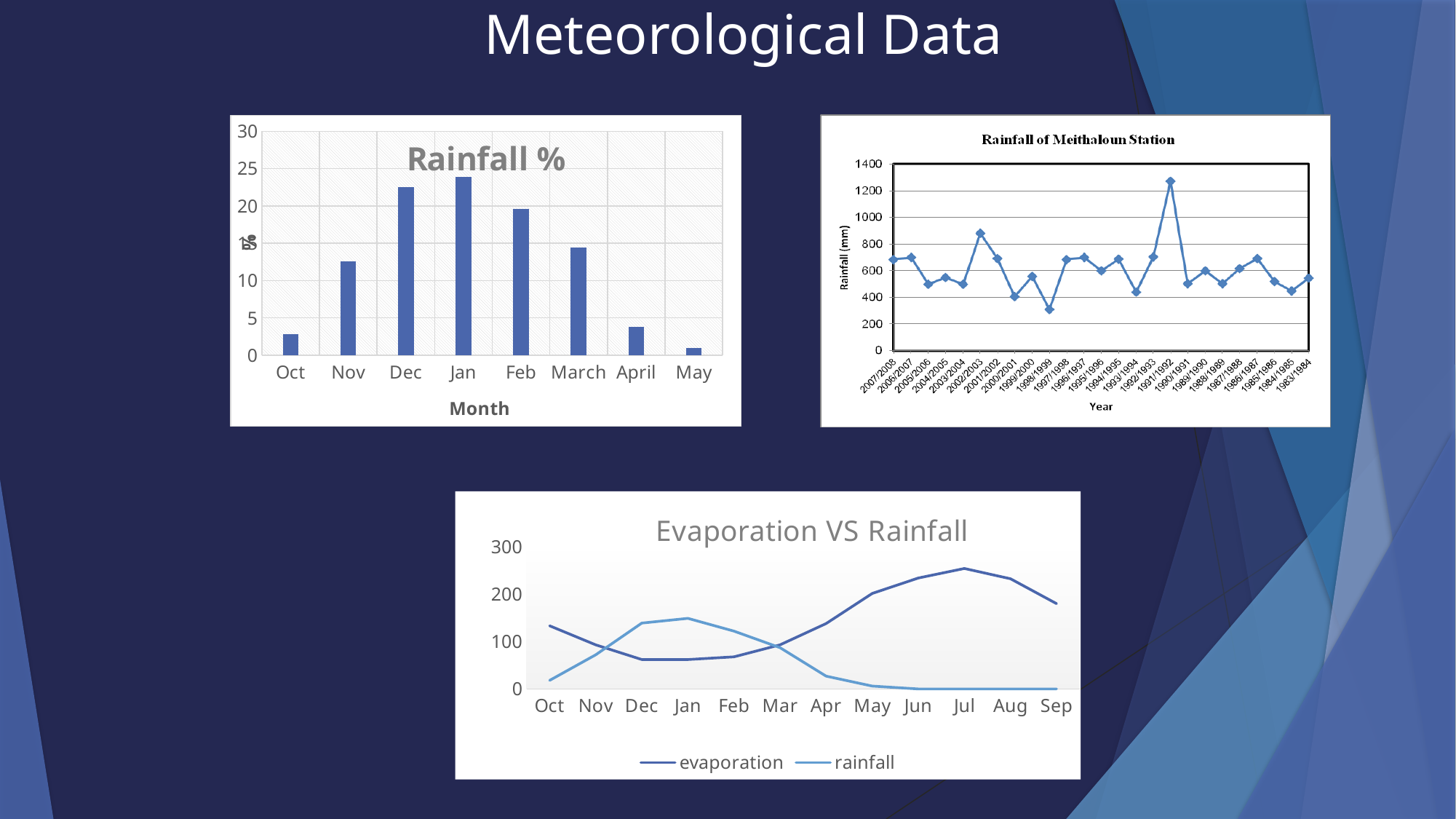
In the Rainfall of Meithaloun Station chart, is the value for 1991/1992 greater or less than 1000? greater What kind of chart is the Rainfall % chart? bar chart In the Rainfall % chart, which month has the highest value? Jan How many series does the legend of the Evaporation VS Rainfall chart list? 2 In the Rainfall % chart, which is larger, the value for Nov or the value for March? March In the Rainfall % chart, which month has the lowest value? May In the Rainfall of Meithaloun Station chart, which year has the lowest rainfall? 1998/1999 How many months are shown in the Rainfall % chart? 8 In the Evaporation VS Rainfall chart, which month has the highest evaporation value? Jul In the Rainfall % chart, is the value for April greater or less than 5? less In the Rainfall % chart, is the value for Dec greater or less than 20? greater In the Rainfall of Meithaloun Station chart, which year has the highest rainfall? 1991/1992